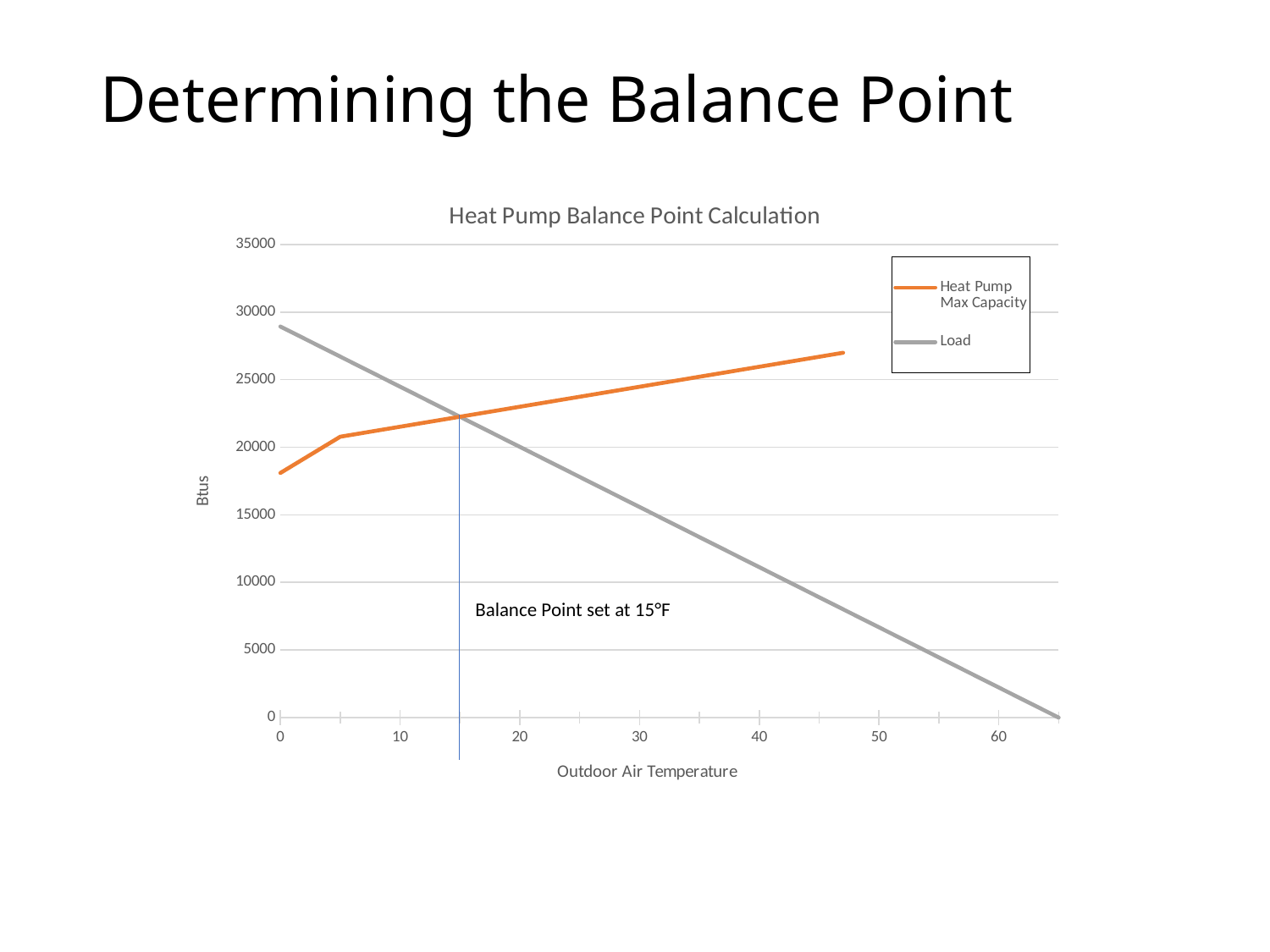
Does the Heat Pump Max Capacity series rise or fall as Outdoor Air Temperature increases? rise What kind of chart is shown on the slide? line chart Does the Load series rise or fall as Outdoor Air Temperature increases? fall Is the Load value at an Outdoor Air Temperature of 60 greater or less than 5000? less At what Outdoor Air Temperature is the Balance Point set, according to the annotation on the chart? 15°F Is the Heat Pump Max Capacity value at an Outdoor Air Temperature of 0 greater or less than 20000? less Is the Load value at an Outdoor Air Temperature of 0 greater or less than 25000? greater Which series is drawn in orange? Heat Pump Max Capacity At an Outdoor Air Temperature of 40, which series has the higher value, Heat Pump Max Capacity or Load? Heat Pump Max Capacity At an Outdoor Air Temperature of 0, which series has the higher value, Heat Pump Max Capacity or Load? Load What is the title of the chart? Heat Pump Balance Point Calculation How many series does the legend list? 2